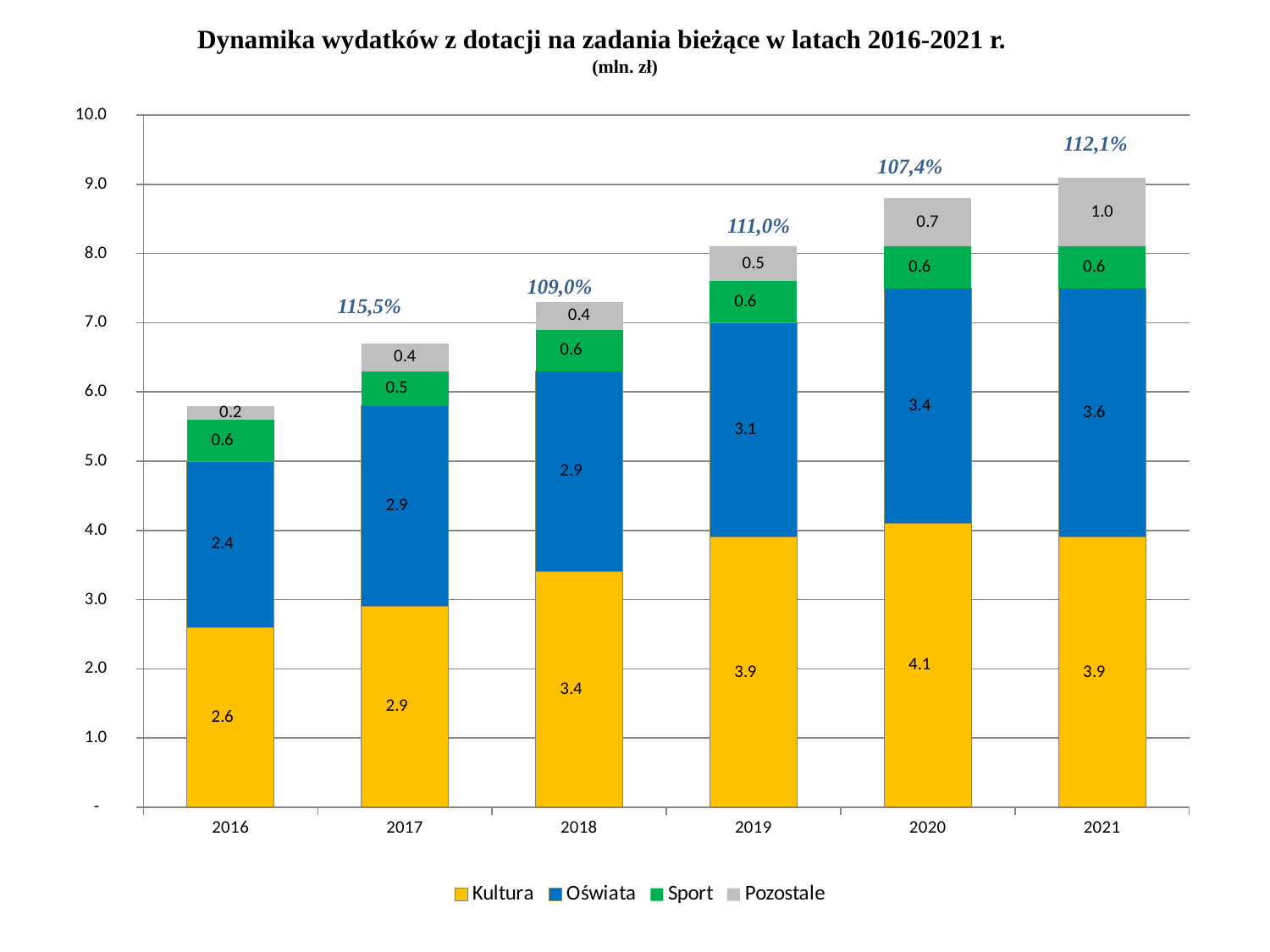
In which year is the Oświata value lowest? 2016 What percentage label is shown above the 2017 bar? 115,5% How many years are shown on the x axis? 6 What is the difference between the Kultura values for 2020 and 2016? 1.5 What is the value for Oświata in 2021? 3.6 In which year is the Kultura value highest? 2020 What is the value for Pozostale in 2016? 0.2 What is the total of the stacked bar for 2021? 9.1 What kind of chart is shown on the slide? Stacked bar chart How many series does the legend list? 4 What is the value for Kultura in 2020? 4.1 Which is larger, the Oświata value in 2019 or the Oświata value in 2020? 2020